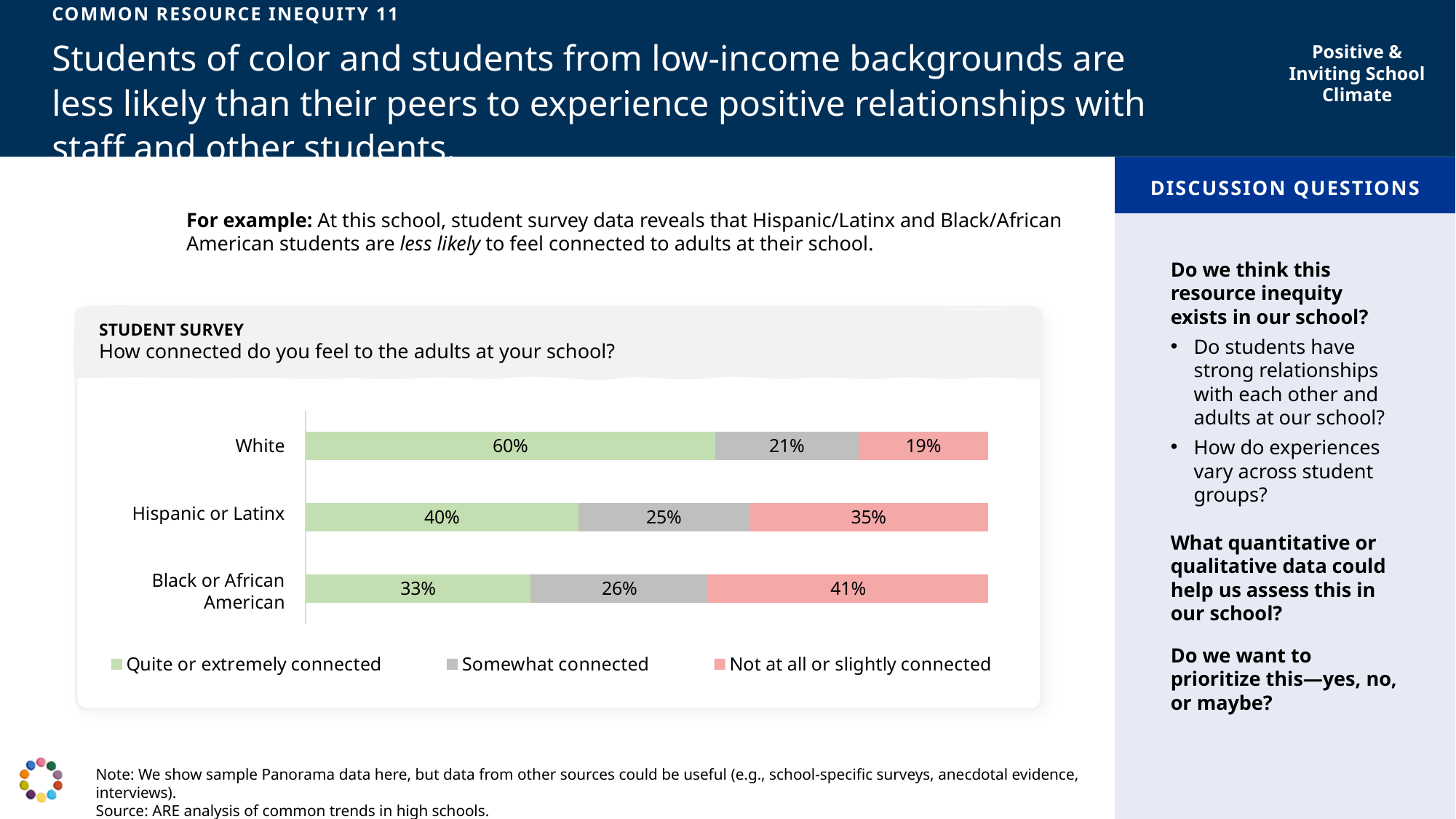
What is the total of the three segments in the Hispanic or Latinx bar? 100% How many student groups are shown in the chart? 3 How many series does the legend list? 3 Which student group has the lowest share of students who feel quite or extremely connected? Black or African American What kind of chart is shown on the slide? Stacked bar chart What percentage of Hispanic or Latinx students reported feeling somewhat connected? 25% Which student group has the highest share of students who feel quite or extremely connected? White What is the difference in percentage points between White and Black or African American students who feel quite or extremely connected? 27 Which group has a larger share of students who feel not at all or slightly connected: Hispanic or Latinx or White? Hispanic or Latinx What percentage of White students reported feeling quite or extremely connected to adults at their school? 60% What survey question does the chart show responses to? How connected do you feel to the adults at your school? What percentage of Black or African American students reported feeling not at all or slightly connected? 41%